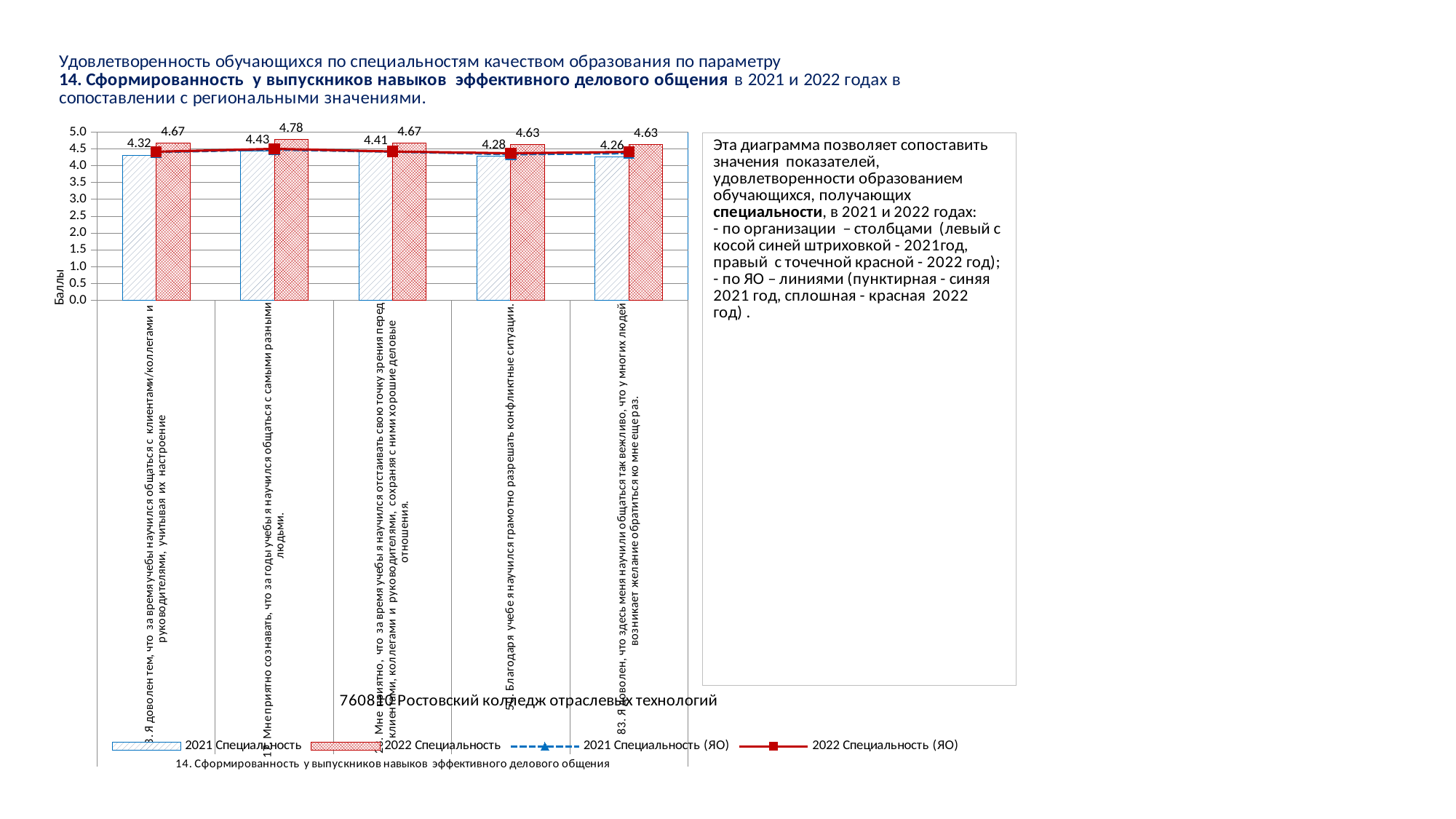
Is the 2021 Специальность (ЯО) line value for the first category greater or less than 4.0? greater Which category has the lowest 2021 Специальность value? 83. Я доволен, что здесь меня научили общаться так вежливо... (4.26) For the first category, which is larger: the 2021 Специальность value or the 2022 Специальность value? 2022 Специальность (4.67) How many series does the chart legend list? 4 What kind of chart is shown on the slide? bar chart (with line series) What is the title of the vertical axis of the chart? Баллы How many categories are shown on the x axis of the chart? 5 What is the difference between the 2022 Специальность and 2021 Специальность values for the last category (83. Я доволен, что здесь меня научили общаться так вежливо...)? 0.37 What is the value of the 2021 Специальность bar for the category 'Мне приятно сознавать, что за годы учебы я научился общаться с самыми разными людьми'? 4.43 Do the 2021 Специальность values rise or fall from the second category to the fifth category? fall Which category has the highest 2022 Специальность value? Мне приятно сознавать, что за годы учебы я научился общаться с самыми разными людьми (4.78) What is the value of the 2022 Специальность bar for the first category (3. Я доволен тем, что за время учебы научился общаться с клиентами/коллегами и руководителями...)? 4.67